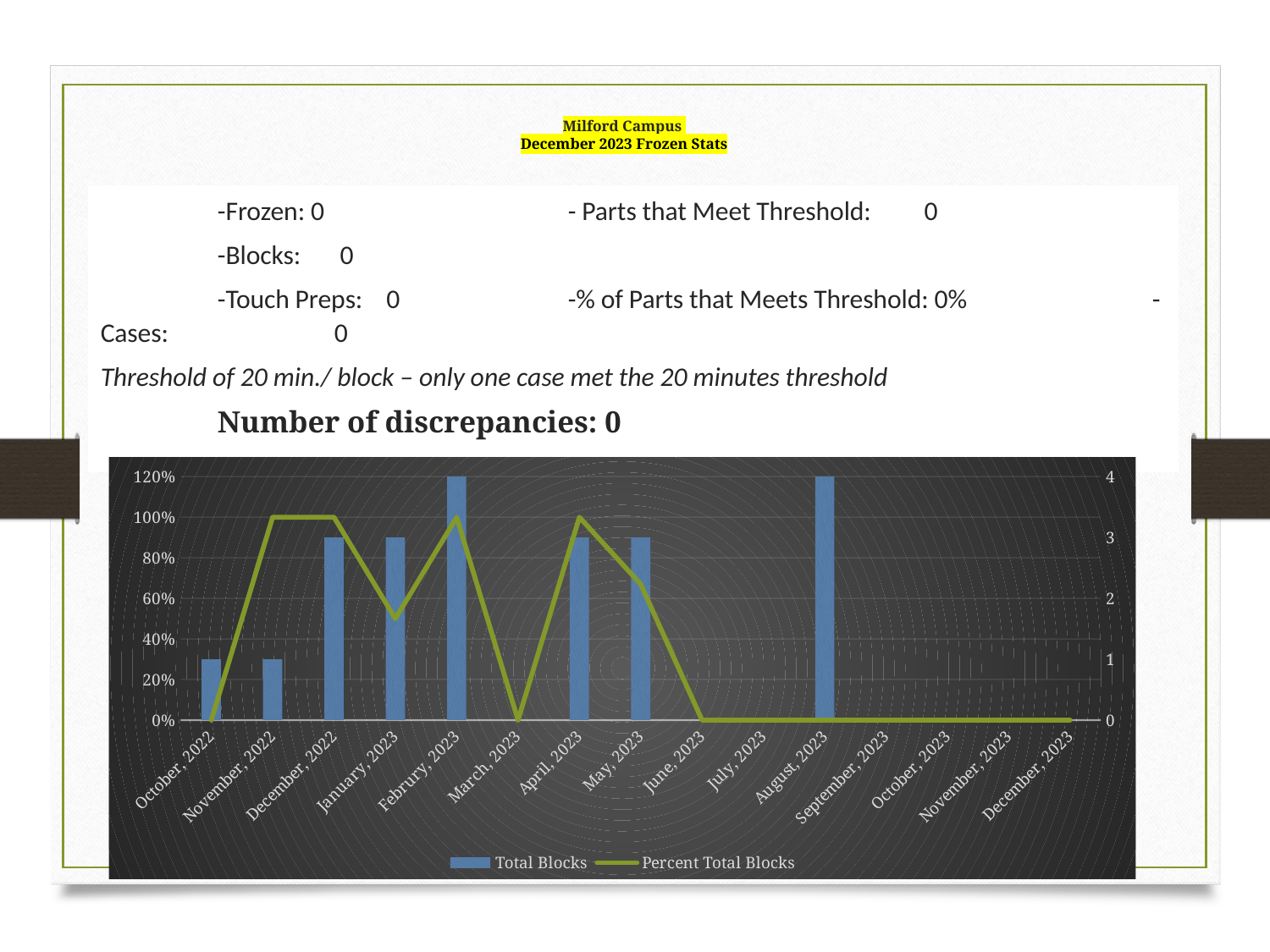
Is the Percent Total Blocks value for January, 2023 greater or less than 80%? less Is the Percent Total Blocks value for May, 2023 greater or less than 40%? greater How many series does the chart legend list? 2 Which has the larger Total Blocks value, December, 2022 or October, 2022? December, 2022 Is the Total Blocks value for December, 2022 greater or less than 2? greater Do the Total Blocks values rise or fall from August, 2023 to December, 2023? fall What kind of chart is shown on the slide? A combination bar and line chart Which has the larger Percent Total Blocks value, April, 2023 or March, 2023? April, 2023 What are the two series named in the chart legend? Total Blocks and Percent Total Blocks What is the Percent Total Blocks value for November, 2022? 100% How many months are shown along the x axis of the chart? 15